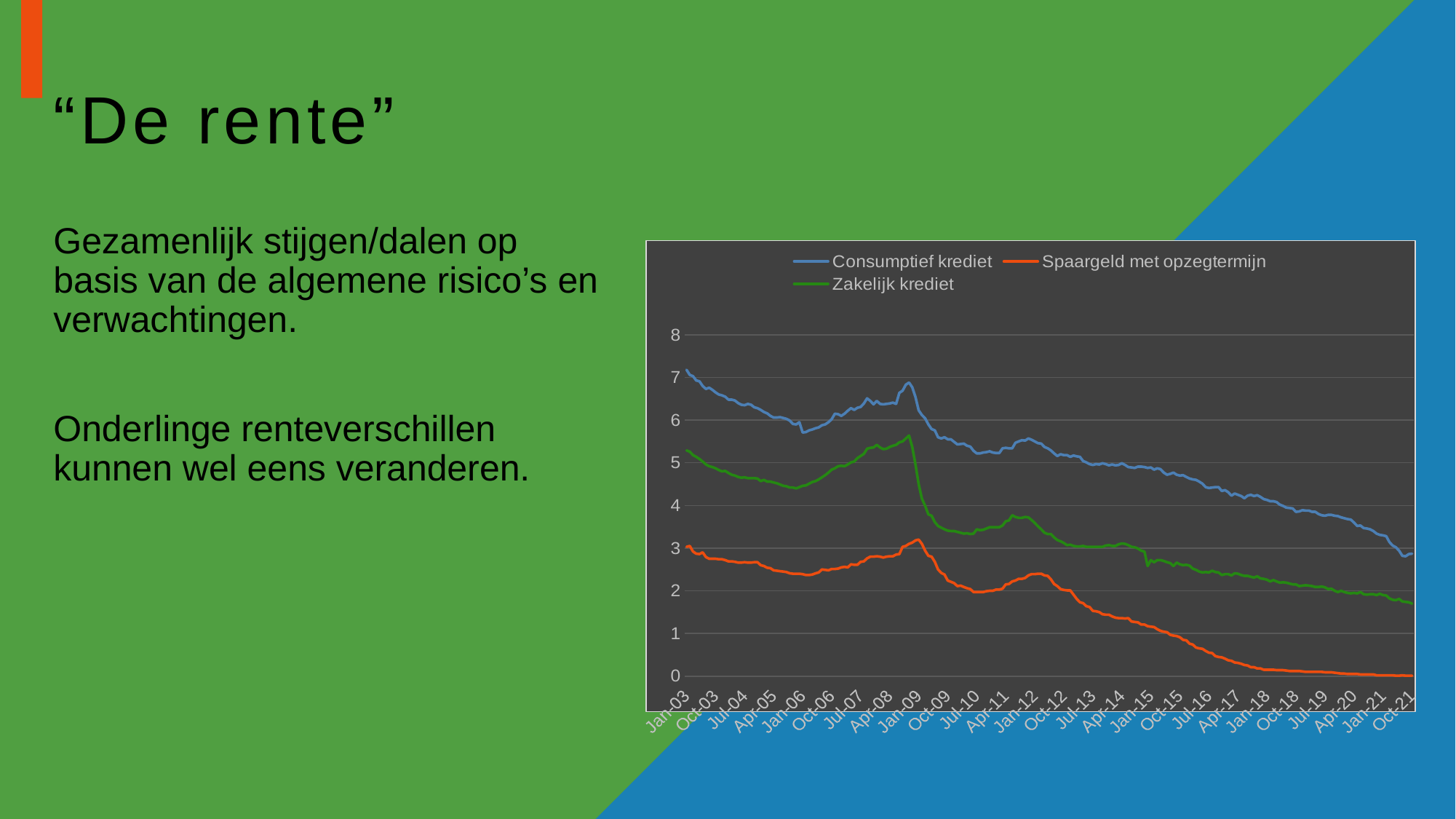
Is the value for Spaargeld met opzegtermijn at Oct-21 greater or less than 1? less Is the value for Zakelijk krediet at Oct-21 greater or less than 2? less Which series has the lowest values across the whole period? Spaargeld met opzegtermijn How many series does the chart's legend list? 3 Which series has the highest value at Oct-21? Consumptief krediet Does the Spaargeld met opzegtermijn line rise or fall overall from Jan-03 to Oct-21? fall At Jan-09, which is higher: Consumptief krediet or Zakelijk krediet? Consumptief krediet Is the value for Zakelijk krediet at Jan-03 greater or less than 5? greater Does the Consumptief krediet line rise or fall overall from Jan-12 to Oct-21? fall What kind of chart is shown on the slide? line chart What colour is the Zakelijk krediet line in the chart? green